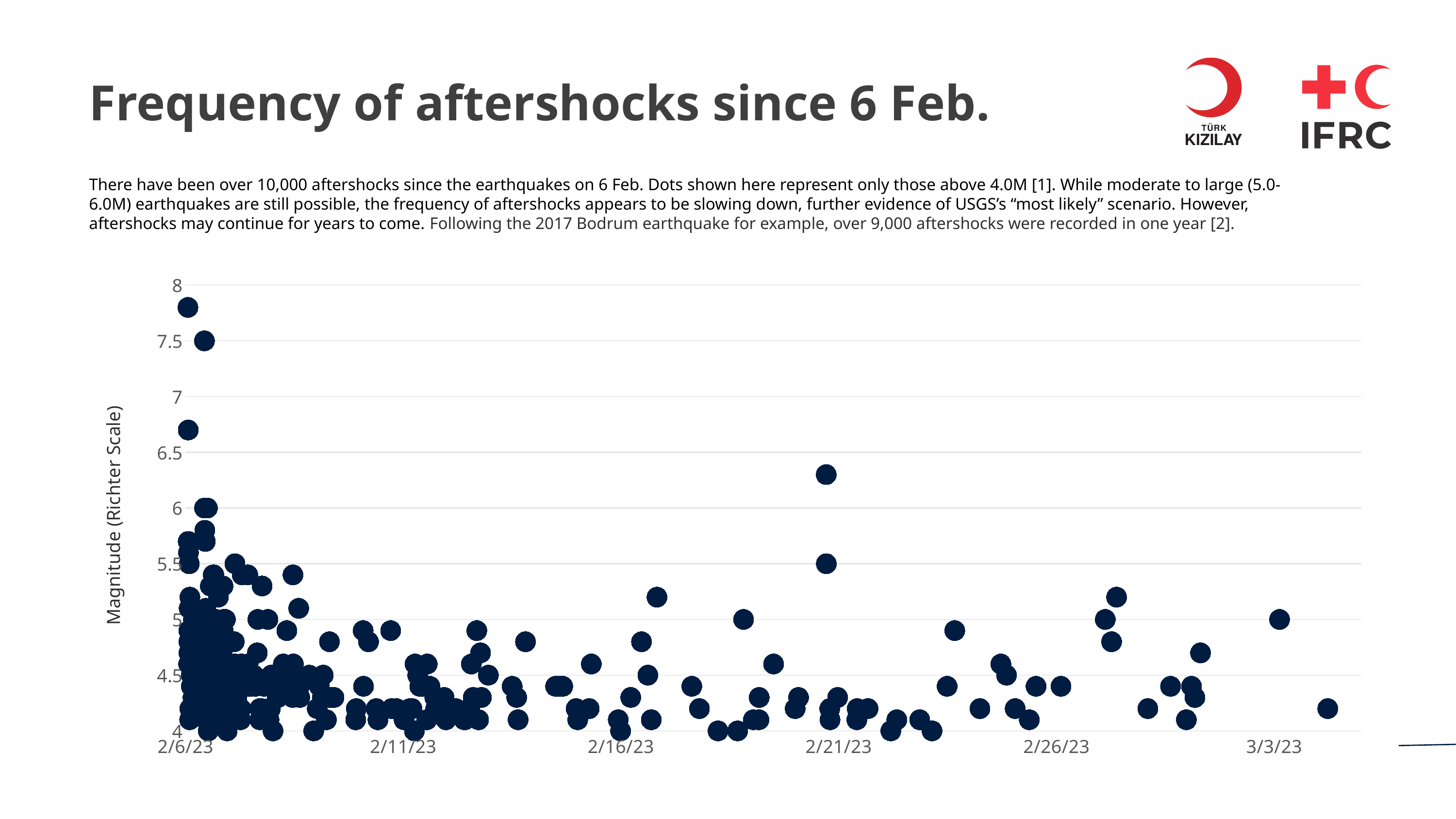
What kind of chart is shown on the slide? scatter chart Is the magnitude of the highest point after 2/21/23 greater or less than 6.5? less Is the highest magnitude near 2/6/23 higher or lower than the highest magnitude near 2/21/23? higher What is the title of the chart? Frequency of aftershocks since 6 Feb. Is the magnitude of the highest point near 2/26/23 greater or less than 5.5? less Is the magnitude of the highest point near 3/3/23 greater or less than 5.5? less What is the label of the y axis? Magnitude (Richter Scale) Does the number of aftershocks plotted per day generally rise or fall along the x axis? fall On which date does the aftershock with the highest magnitude occur? 2/6/23 How many date labels are shown on the x axis? 6